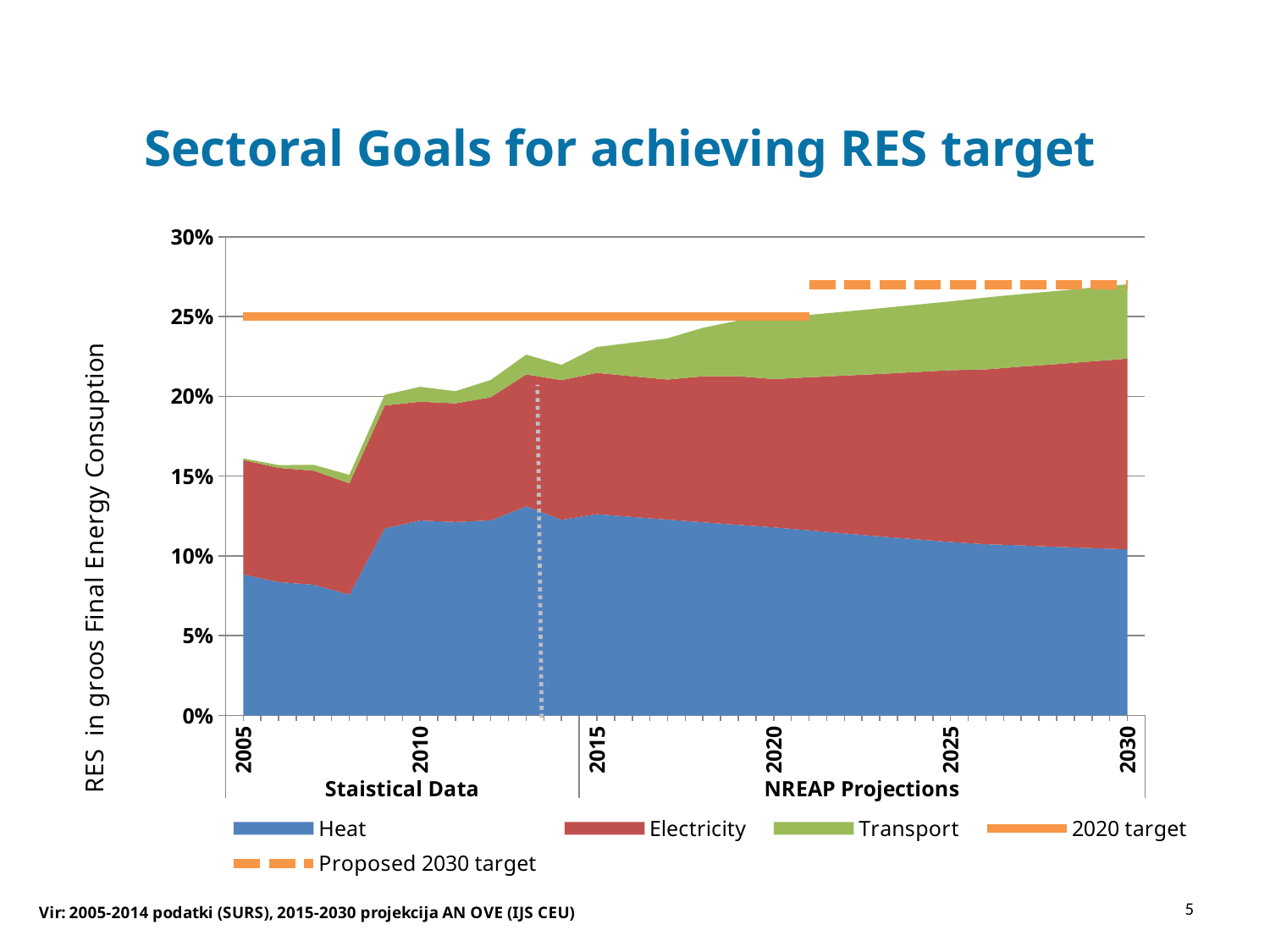
What kind of chart is shown on the slide? Stacked area chart Is the total RES share in 2005 greater or less than 15%? greater At what percentage level is the 2020 target line drawn? 25% How many series does the legend list? 5 Does the Heat share rise or fall from 2015 to 2030? Fall Which legend entry is drawn as a dashed orange line? Proposed 2030 target Is the total RES share in 2030 greater or less than 25%? greater Does the Transport share rise or fall from 2015 to 2030? Rise Is the total RES share in 2015 greater or less than 20%? greater Which sector has the smallest share in 2030? Transport What is the title of the chart? Sectoral Goals for achieving RES target